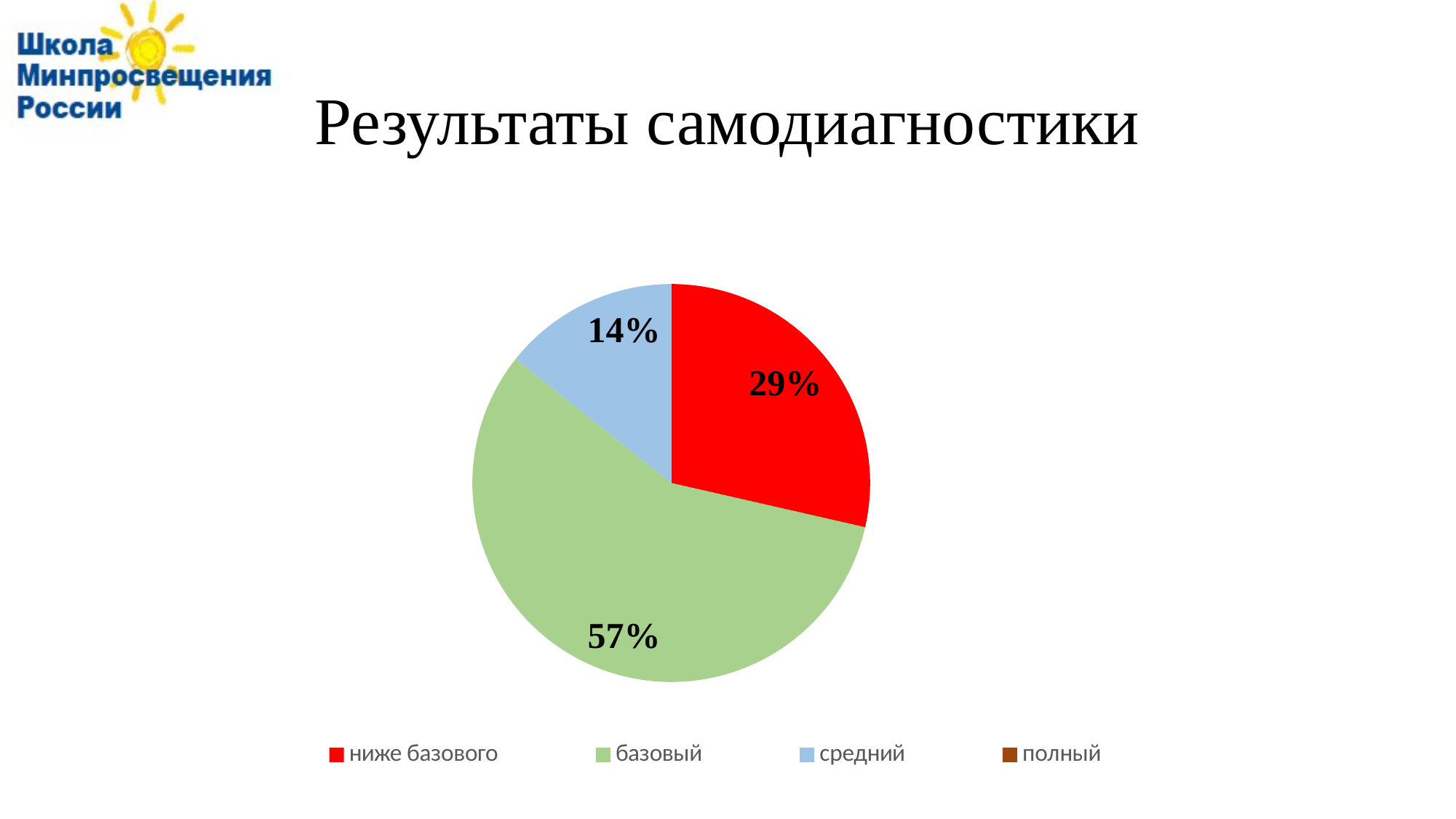
Which is larger, the "ниже базового" slice or the "средний" slice? ниже базового Which category has the largest slice of the pie? базовый What is the difference between the "базовый" share and the "ниже базового" share? 28% What share of the pie does the "базовый" slice represent? 57% How many entries does the legend list? 4 What is the difference between the "ниже базового" share and the "средний" share? 15% Which of the labelled slices is the smallest? средний What is the title of the chart on the slide? Результаты самодиагностики What type of chart is shown on the slide? pie chart What colour is the "ниже базового" slice? red What share of the pie does the "ниже базового" slice represent? 29% What share of the pie does the "средний" slice represent? 14%